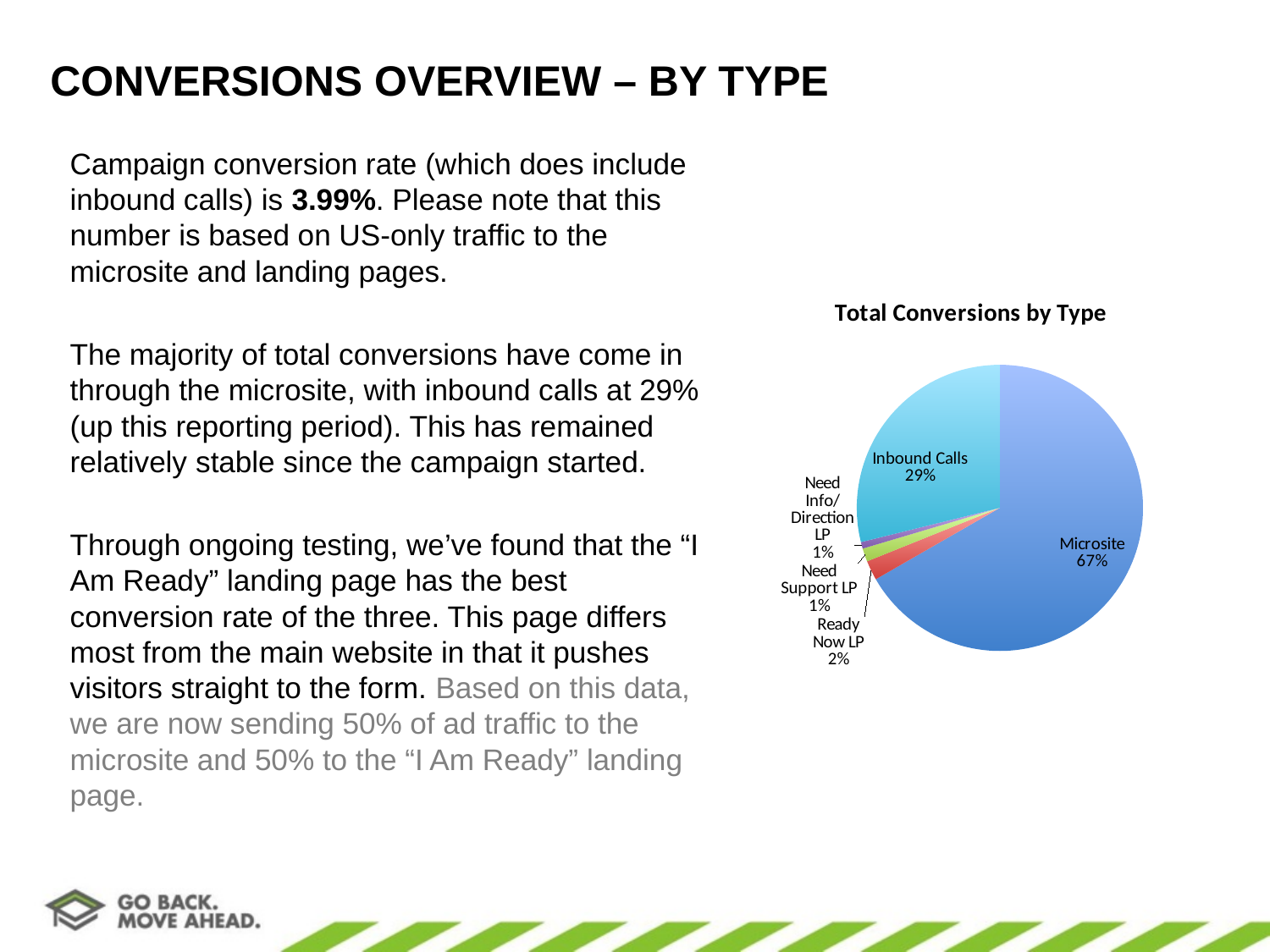
How many slices does the pie chart have? 5 What kind of chart is shown on the slide? Pie chart What percentage is shown for the Ready Now LP slice? 2% Which is larger, the Inbound Calls share or the Ready Now LP share? Inbound Calls What is the combined share of the Ready Now LP, Need Support LP and Need Info/Direction LP slices? 4% What share of total conversions does the Microsite slice represent? 67% What percentage is shown for the Need Info/Direction LP slice? 1% What is the title of the pie chart? Total Conversions by Type What percentage is shown for the Need Support LP slice? 1% What share of total conversions comes from Inbound Calls? 29% Which conversion type has the largest share of the pie? Microsite What is the difference in percentage points between the Microsite and Inbound Calls shares? 38